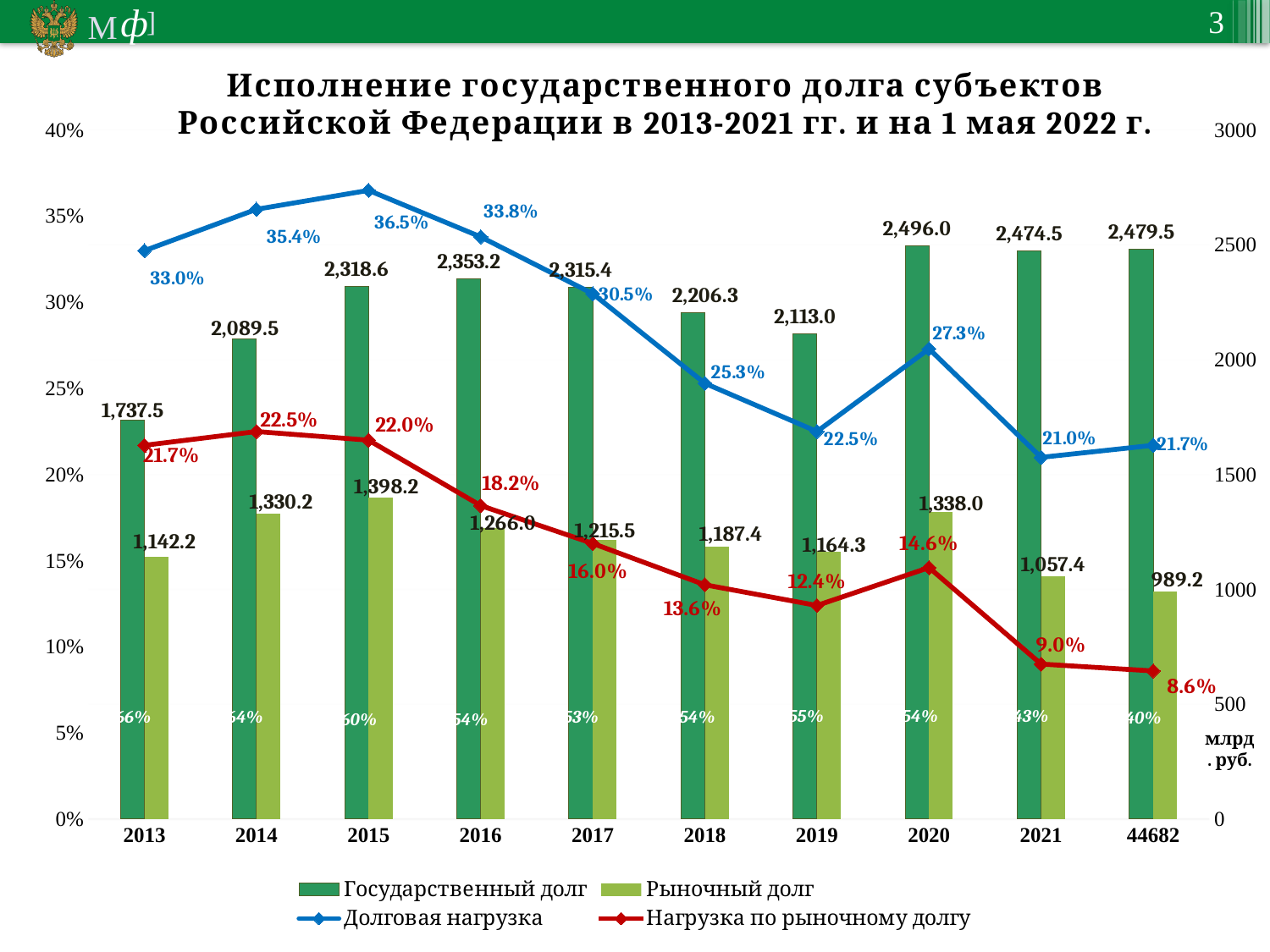
Which is larger: Рыночный долг in 2015 or in 2020? 2015 Does the Нагрузка по рыночному долгу line rise or fall from 2014 to 2019? fall What colour is the Долговая нагрузка line? blue What is the difference between Государственный долг in 2020 and in 2019? 383.0 What is the value of Государственный долг for 2016? 2,353.2 How many series does the legend list? 4 How many categories are shown on the x axis? 10 What is the Долговая нагрузка value for 2015? 36.5% In which year is Государственный долг highest? 2020 What is the value of Рыночный долг for 2021? 1,057.4 In which category is Рыночный долг lowest? 44682 What is the Нагрузка по рыночному долгу value for 2019? 12.4%